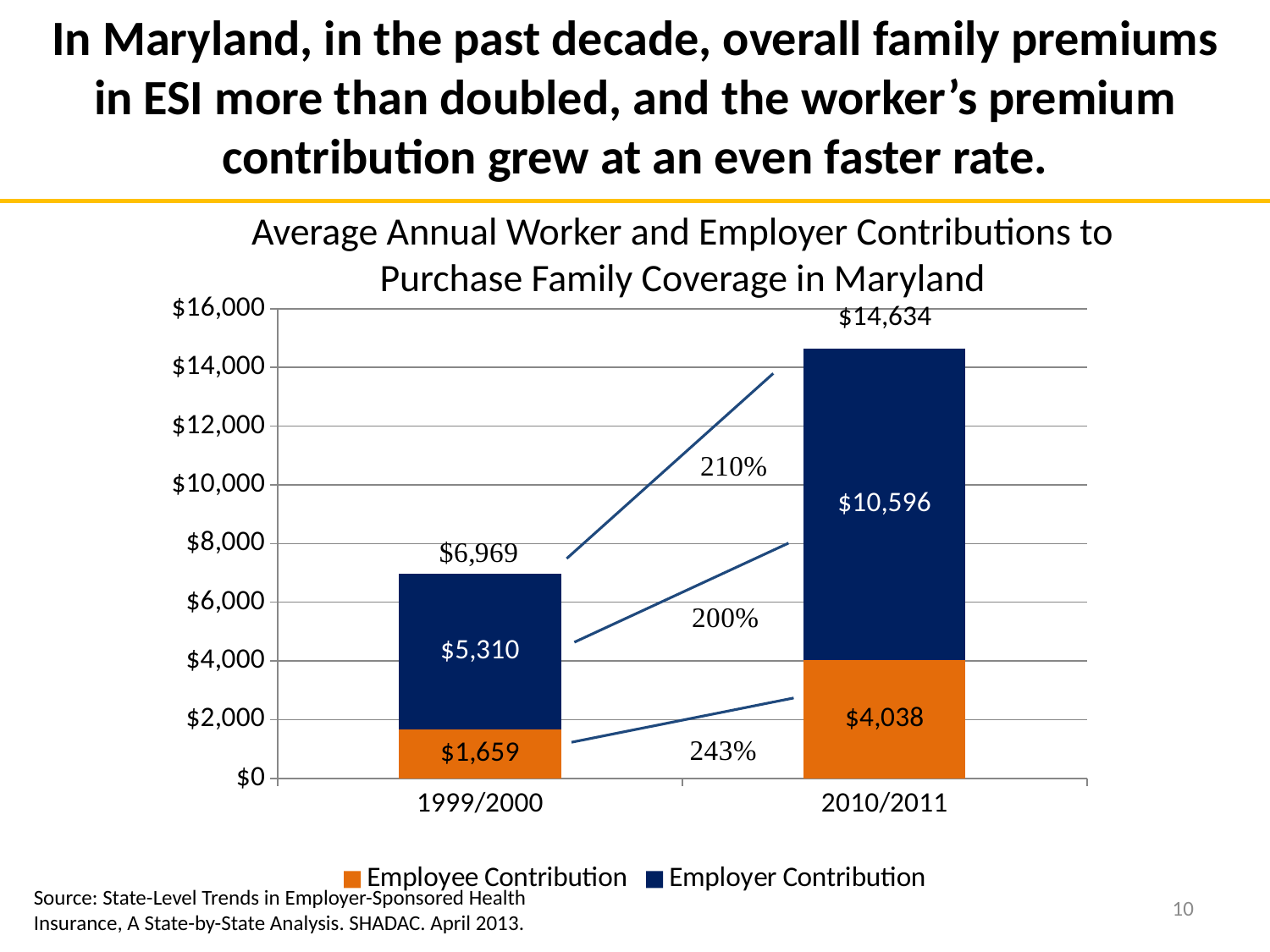
What is the Employee Contribution for 1999/2000? $1,659 How many categories are shown on the x axis? 2 What is the total of the stacked bar for 2010/2011? $14,634 What is the Employee Contribution for 2010/2011? $4,038 Which is larger, the Employee Contribution in 2010/2011 or the Employer Contribution in 1999/2000? Employer Contribution in 1999/2000 What is the difference between the Employer Contribution in 2010/2011 and in 1999/2000? $5,286 What kind of chart is shown on the slide? Stacked bar chart How many series does the legend list? 2 What is the Employer Contribution for 1999/2000? $5,310 What percentage growth is shown for the Employee Contribution between 1999/2000 and 2010/2011? 243% What is the total of the stacked bar for 1999/2000? $6,969 What is the Employer Contribution for 2010/2011? $10,596